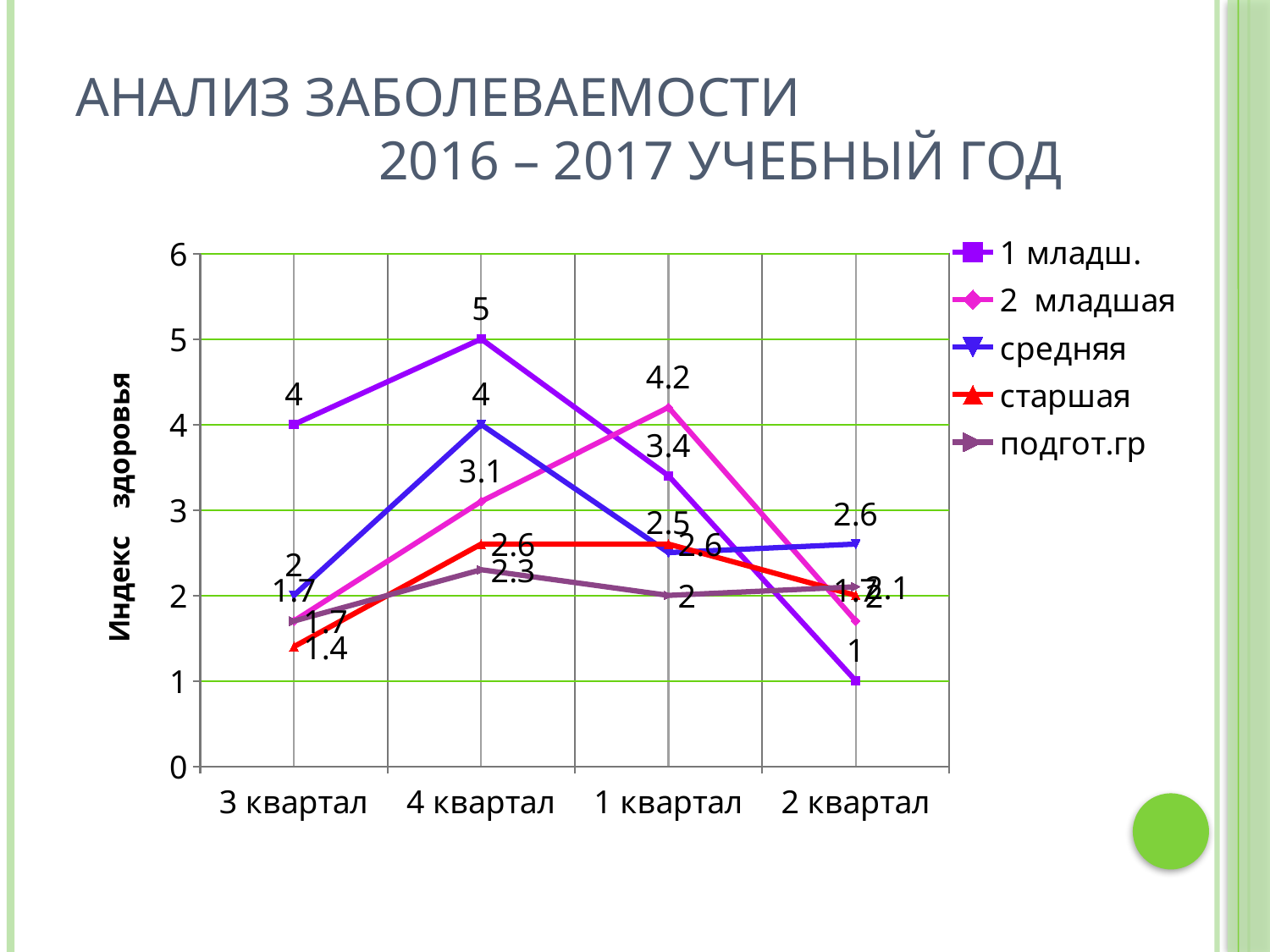
What kind of chart is shown on the slide? line chart What is the value for 1 младш. at 4 квартал? 5 What is the value for 1 младш. at 2 квартал? 1 How many series does the legend list? 5 At 4 квартал, which is larger: 1 младш. or средняя? 1 младш. What is the value for 2 младшая at 1 квартал? 4.2 How many quarters are shown on the x axis? 4 What is the value for подгот.гр at 4 квартал? 2.3 What is the value for старшая at 3 квартал? 1.4 In which quarter does 1 младш. reach its highest value? 4 квартал What is the difference between the 1 младш. values at 4 квартал and 2 квартал? 4 What is the value for средняя at 4 квартал? 4